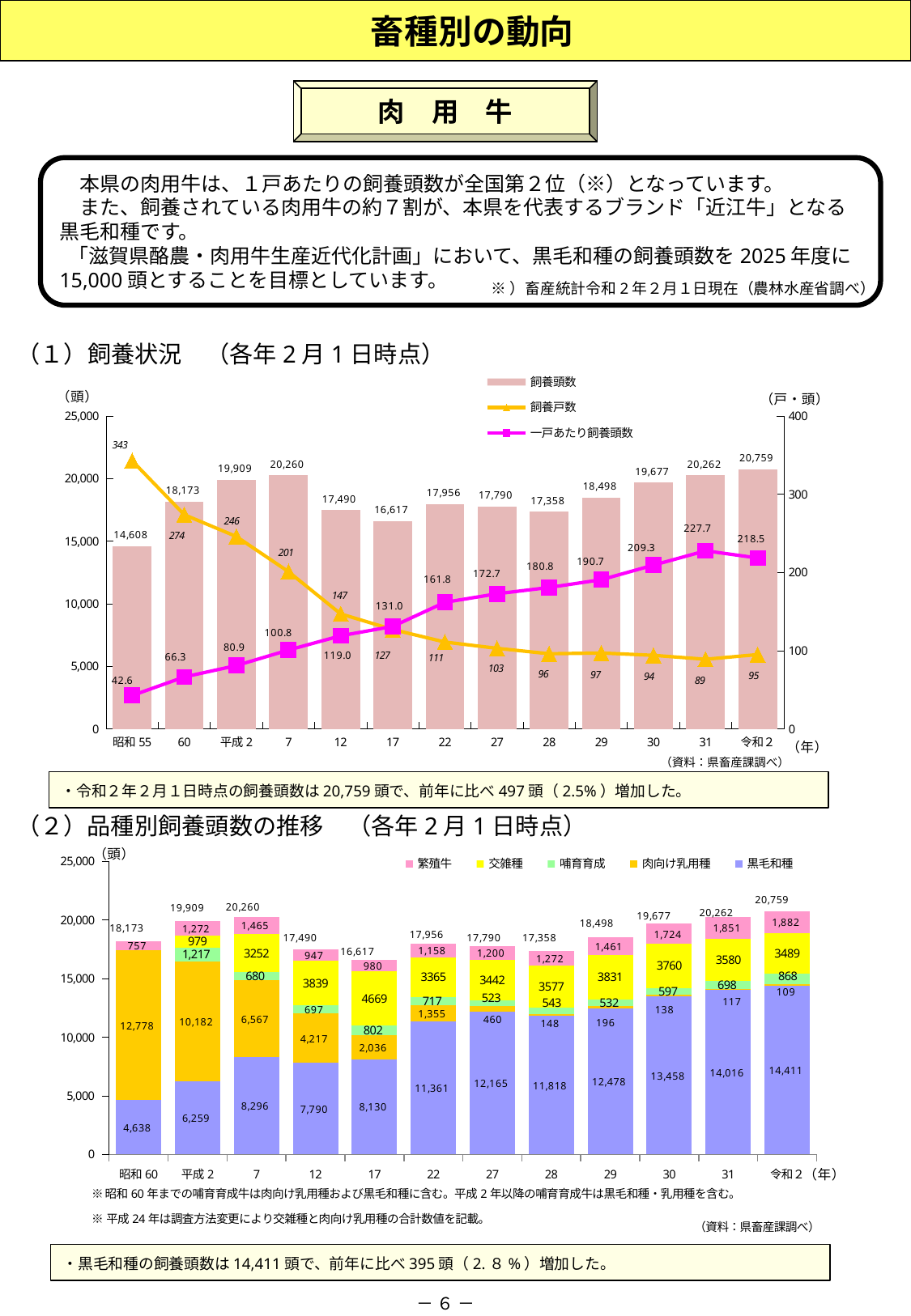
How many years are shown on the x axis of the 品種別飼養頭数の推移 chart? 12 In the 品種別飼養頭数の推移 chart, what is the total of the stacked bar for 令和2? 20,759 In the 品種別飼養頭数の推移 chart, which is larger for 平成2: 黒毛和種 or 肉向け乳用種? 肉向け乳用種 In the 飼養状況 chart, what is the difference in 飼養頭数 between 令和2 and 31? 497 How many series does the legend of the 飼養状況 chart list? 3 How many series does the legend of the 品種別飼養頭数の推移 chart list? 5 In the 品種別飼養頭数の推移 chart, what is the 黒毛和種 value for 令和2? 14,411 In the 飼養状況 chart, what is the 一戸あたり飼養頭数 value for 平成12? 119.0 In the 飼養状況 chart, what is the 飼養頭数 value for 令和2? 20,759 In the 飼養状況 chart, does the 飼養戸数 line generally rise or fall from 昭和55 to 令和2? fall In the 飼養状況 chart, which year has the lowest 飼養戸数? 31 In the 飼養状況 chart, which year has the highest 飼養頭数? 令和2